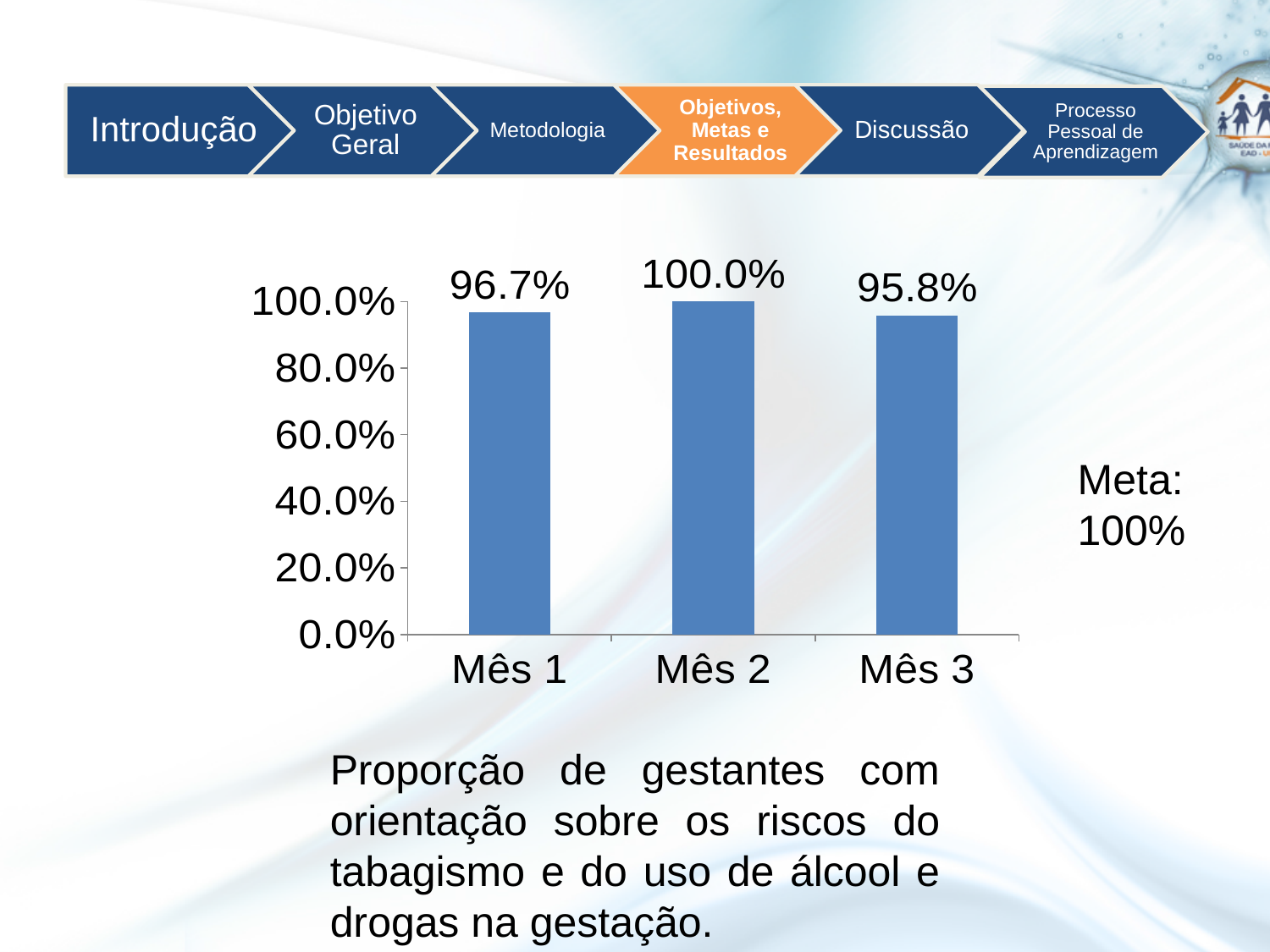
Which month has the lowest value? Mês 3 What is the value for Mês 3? 95.8% What is the value for Mês 2? 100.0% How many months are shown on the x axis? 3 What target (Meta) is stated next to the chart? 100% What is the difference between the values for Mês 1 and Mês 3? 0.9% Which is larger, the value for Mês 1 or the value for Mês 2? Mês 2 What is the difference between the values for Mês 2 and Mês 3? 4.2% What kind of chart is shown on the slide? bar chart Which month has the highest value? Mês 2 Is the value for Mês 3 greater or less than 80.0%? greater What is the value for Mês 1? 96.7%